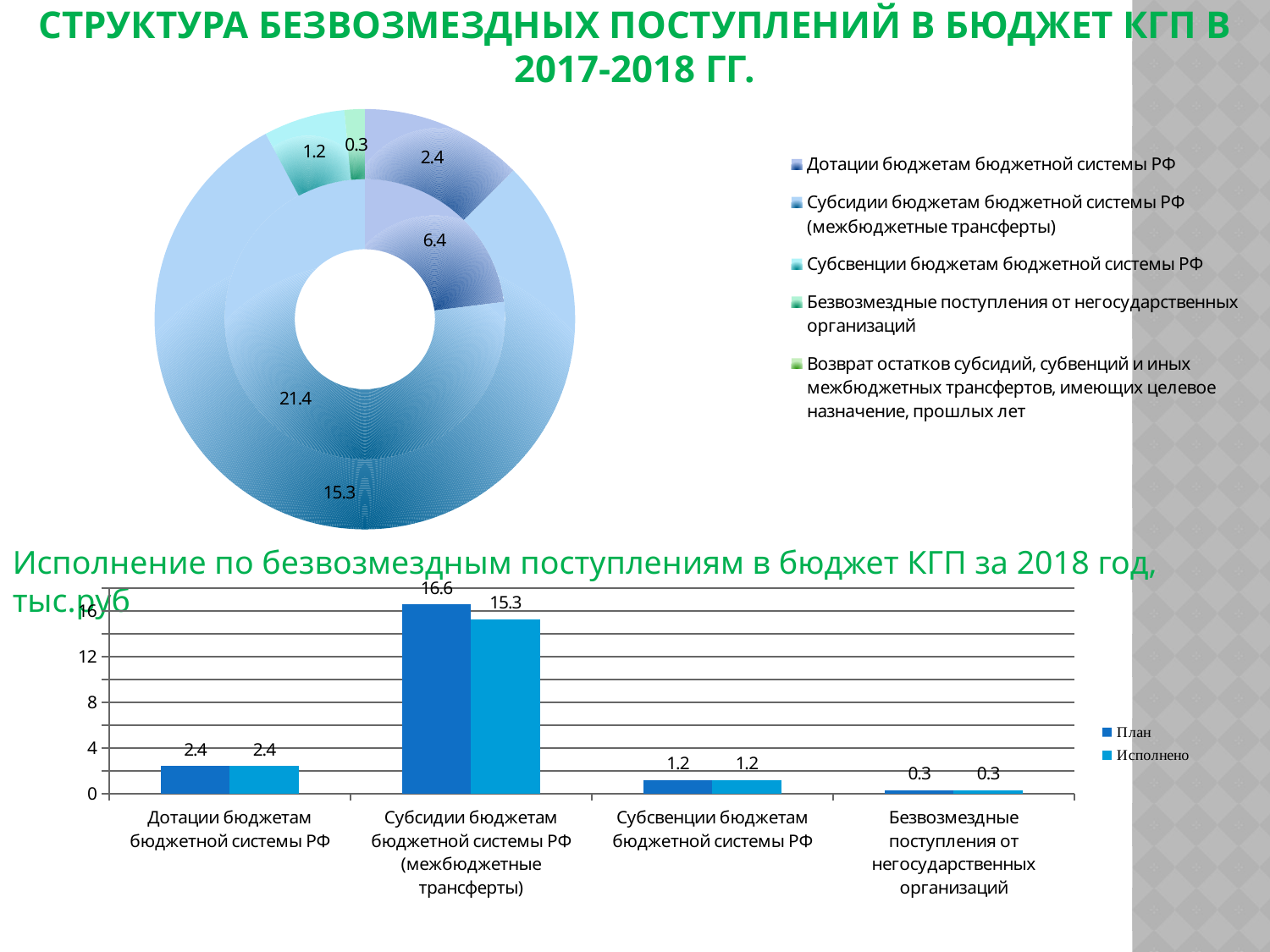
In the lower bar chart, what is the Исполнено value for 'Дотации бюджетам бюджетной системы РФ'? 2.4 In the lower bar chart, what is the difference between the План and Исполнено values for 'Субсидии бюджетам бюджетной системы РФ (межбюджетные трансферты)'? 1.3 What kind of chart is the upper chart under the title 'СТРУКТУРА БЕЗВОЗМЕЗДНЫХ ПОСТУПЛЕНИЙ В БЮДЖЕТ КГП В 2017-2018 ГГ.'? doughnut chart In the lower bar chart, which is larger for 'Субсидии бюджетам бюджетной системы РФ (межбюджетные трансферты)': План or Исполнено? План How many entries does the legend of the upper doughnut chart list? 5 In the lower bar chart, which category has the lowest Исполнено value? Безвозмездные поступления от негосударственных организаций In the lower bar chart, how many series does the legend list? 2 How many categories are shown on the x axis of the lower bar chart? 4 What kind of chart is the lower chart titled 'Исполнение по безвозмездным поступлениям в бюджет КГП за 2018 год, тыс.руб'? bar chart In the lower bar chart, what is the Исполнено value for 'Субсидии бюджетам бюджетной системы РФ (межбюджетные трансферты)'? 15.3 In the lower bar chart, which category has the highest План value? Субсидии бюджетам бюджетной системы РФ (межбюджетные трансферты) In the lower bar chart, what is the План value for 'Субсидии бюджетам бюджетной системы РФ (межбюджетные трансферты)'? 16.6